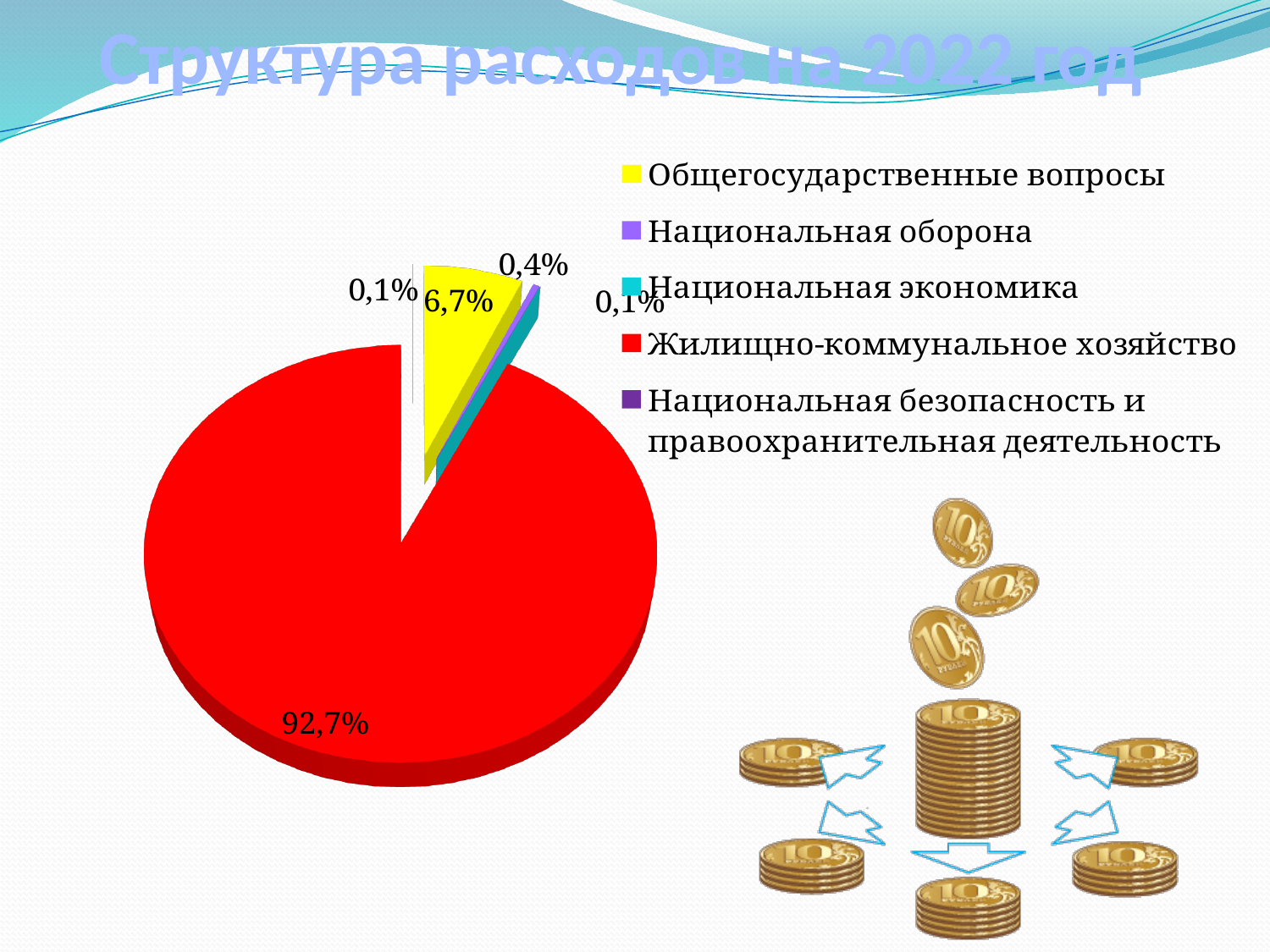
What is the largest percentage value labelled on the pie chart? 92,7% What is the difference between the share for Жилищно-коммунальное хозяйство and the share for Общегосударственные вопросы? 86,0% What is the smallest percentage value labelled on the pie chart? 0,1% What share of the pie does Общегосударственные вопросы take? 6,7% What colour is the slice for Жилищно-коммунальное хозяйство? red What is the title of the chart on the slide? Структура расходов на 2022 год Which is larger: the slice for Жилищно-коммунальное хозяйство or the slice for Общегосударственные вопросы? Жилищно-коммунальное хозяйство What kind of chart is shown on the slide? pie chart How many categories does the legend of the pie chart list? 5 Which category has the largest slice of the pie? Жилищно-коммунальное хозяйство What share of the pie does Жилищно-коммунальное хозяйство take? 92,7%